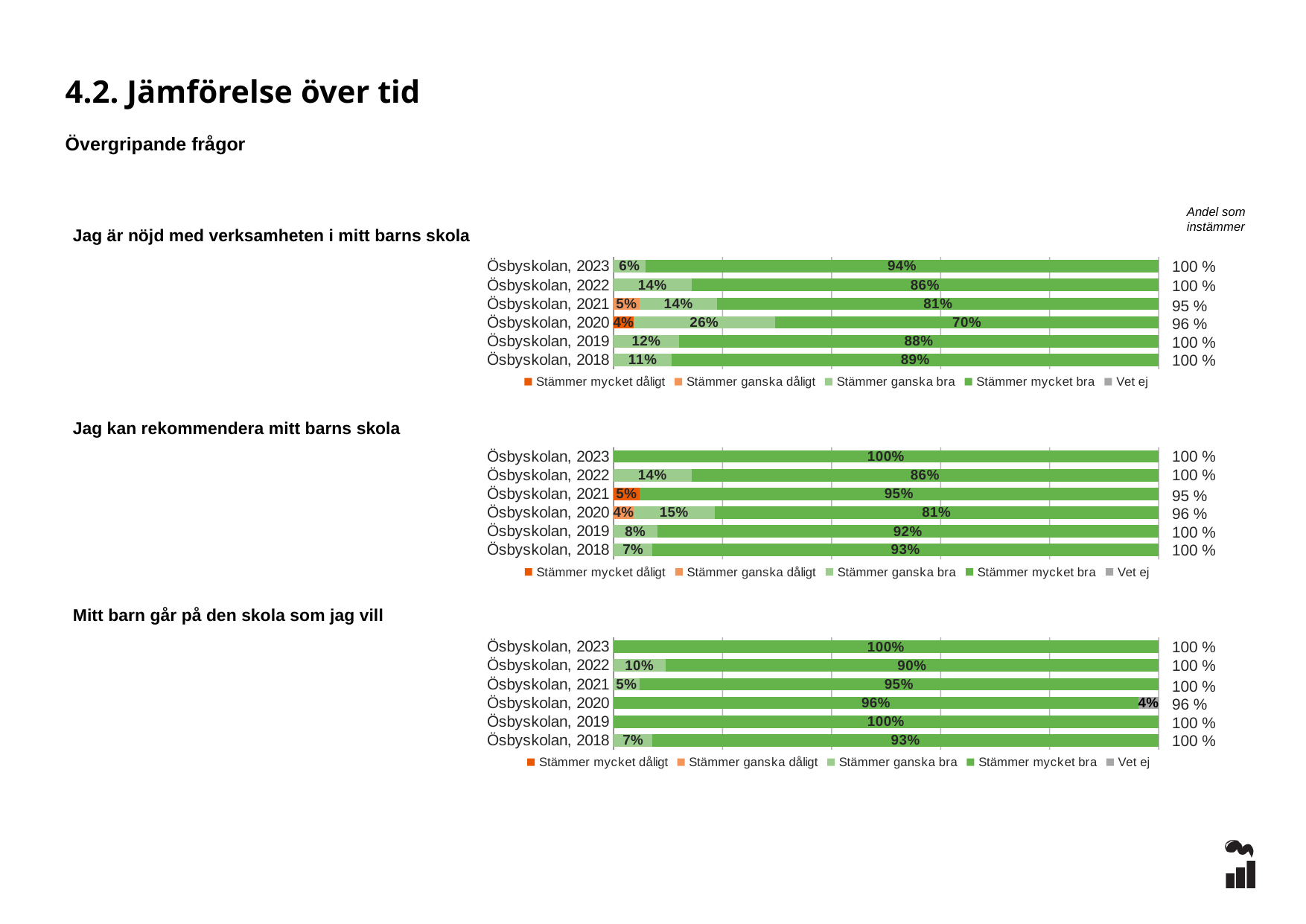
In the chart 'Jag är nöjd med verksamheten i mitt barns skola', what is the value for 'Stämmer mycket bra' for Ösbyskolan, 2023? 94% What kind of chart is 'Jag kan rekommendera mitt barns skola'? Stacked bar chart In the chart 'Jag kan rekommendera mitt barns skola', what is the value for 'Stämmer mycket bra' for Ösbyskolan, 2020? 81% How many categories (years) are shown in the chart 'Mitt barn går på den skola som jag vill'? 6 In the chart 'Jag är nöjd med verksamheten i mitt barns skola', what is the difference between the 'Stämmer mycket bra' values for Ösbyskolan, 2023 and Ösbyskolan, 2022? 8% In the chart 'Jag är nöjd med verksamheten i mitt barns skola', which year has the lowest value for 'Stämmer mycket bra'? Ösbyskolan, 2020 In the chart 'Mitt barn går på den skola som jag vill', what is the value for 'Stämmer ganska bra' for Ösbyskolan, 2022? 10% In the chart 'Jag är nöjd med verksamheten i mitt barns skola', what is the value for 'Stämmer ganska bra' for Ösbyskolan, 2020? 26% In the chart 'Mitt barn går på den skola som jag vill', what is the value for 'Vet ej' for Ösbyskolan, 2020? 4% In the chart 'Jag kan rekommendera mitt barns skola', what is the value for 'Stämmer mycket dåligt' for Ösbyskolan, 2021? 5% In the chart 'Jag kan rekommendera mitt barns skola', which is larger: the 'Stämmer mycket bra' value for Ösbyskolan, 2019 or for Ösbyskolan, 2022? Ösbyskolan, 2019 How many series does the legend of the chart 'Jag är nöjd med verksamheten i mitt barns skola' list? 5